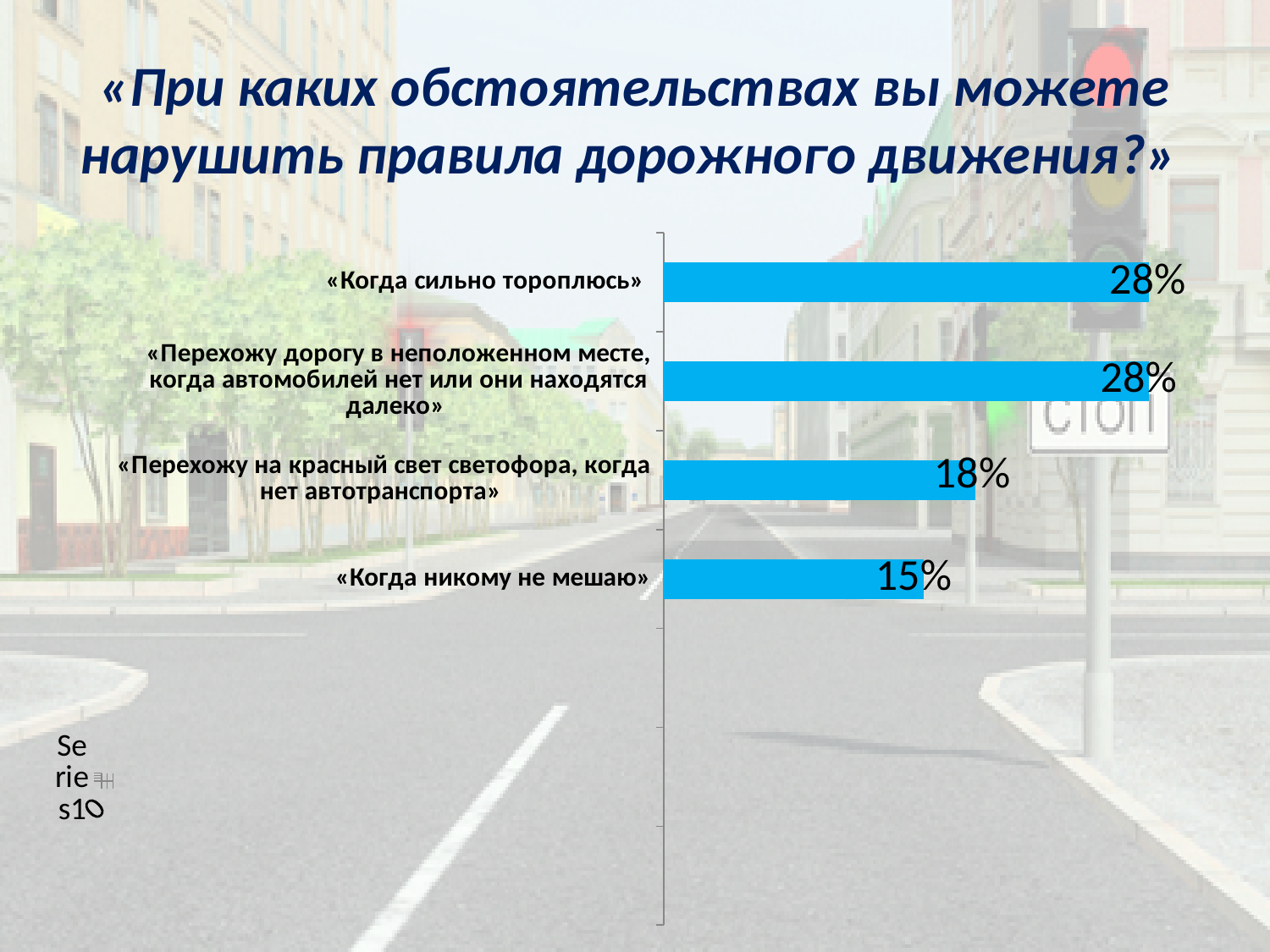
What is the value for «Перехожу дорогу в неположенном месте, когда автомобилей нет или они находятся далеко»? 28% Which is larger: the value for «Перехожу на красный свет светофора, когда нет автотранспорта» or for «Когда никому не мешаю»? «Перехожу на красный свет светофора, когда нет автотранспорта» How many categories are shown in the chart? 4 What is the difference between the values for «Перехожу на красный свет светофора, когда нет автотранспорта» and «Когда никому не мешаю»? 3 percentage points What is the value for «Когда никому не мешаю»? 15% What colour are the bars in the chart? Blue What kind of chart is shown on the slide? Bar chart What is the value for «Когда сильно тороплюсь»? 28% What is the value for «Перехожу на красный свет светофора, когда нет автотранспорта»? 18% Which category has the lowest value? «Когда никому не мешаю» What is the difference between the values for «Когда сильно тороплюсь» and «Когда никому не мешаю»? 13 percentage points Do the two top categories, «Когда сильно тороплюсь» and «Перехожу дорогу в неположенном месте...», have the same value? Yes, both 28%